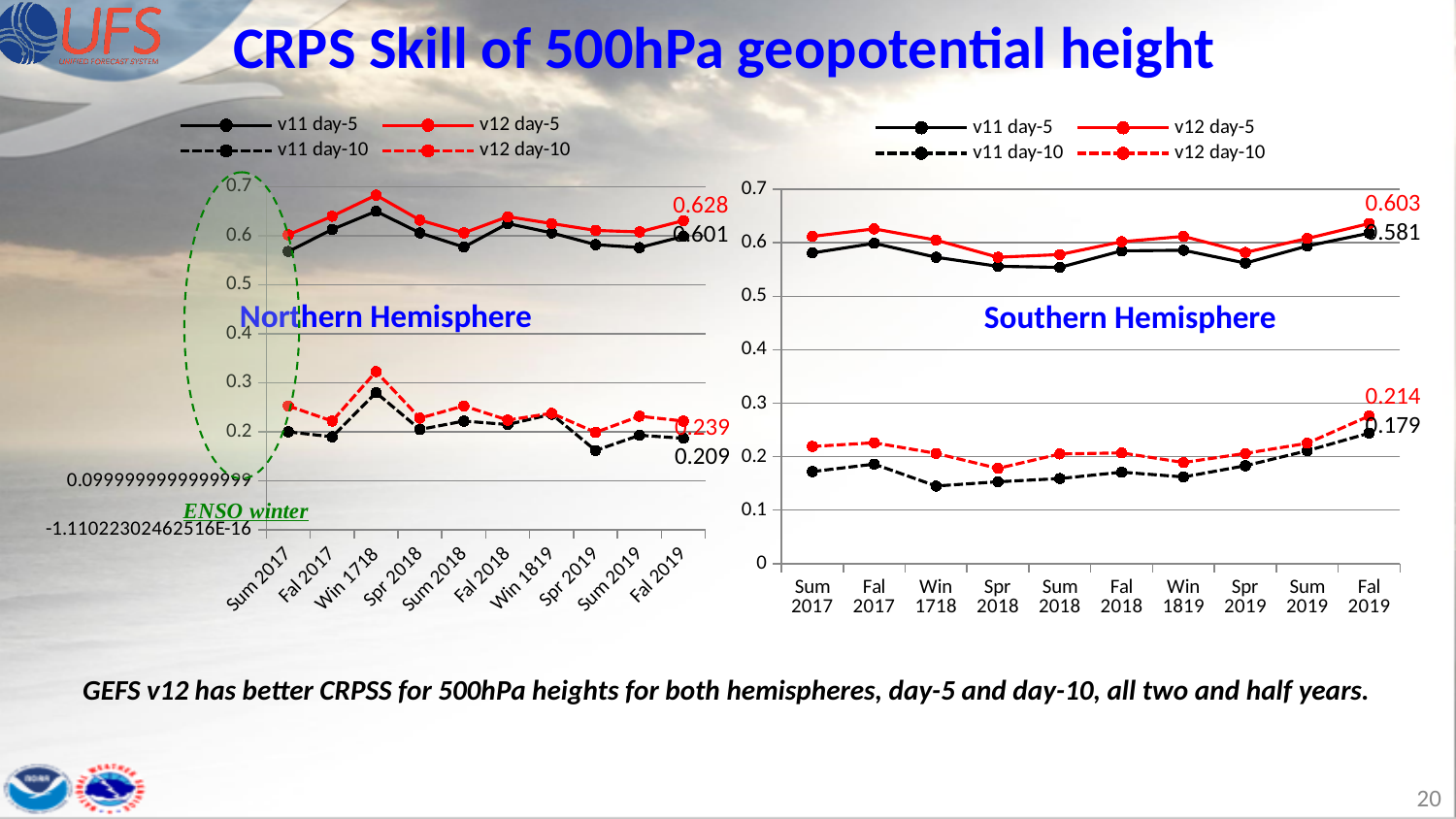
What type of chart is the Northern Hemisphere chart? line chart In the Northern Hemisphere chart, what is the labeled value of v11 day-10 at Fal 2019? 0.209 In the Northern Hemisphere chart, what is the labeled value of v12 day-5 at Fal 2019? 0.628 In the Southern Hemisphere chart, what is the difference between the Fal 2019 values of v12 day-5 and v11 day-5? 0.022 In the Southern Hemisphere chart, is the value for v12 day-5 at Fal 2017 greater or less than 0.6? greater How many series does the legend of the Southern Hemisphere chart list? 4 In the Northern Hemisphere chart, at which season does v12 day-5 reach its highest value? Win 1718 In the Southern Hemisphere chart, what is the labeled value of v11 day-5 at Fal 2019? 0.581 In the Southern Hemisphere chart, what is the labeled value of v12 day-10 at Fal 2019? 0.214 In the Northern Hemisphere chart, what is the difference between the Fal 2019 values of v12 day-10 and v11 day-10? 0.030 In the Northern Hemisphere chart, at which season does v11 day-10 reach its lowest value? Spr 2019 How many seasons are plotted along the x axis of the Southern Hemisphere chart? 10